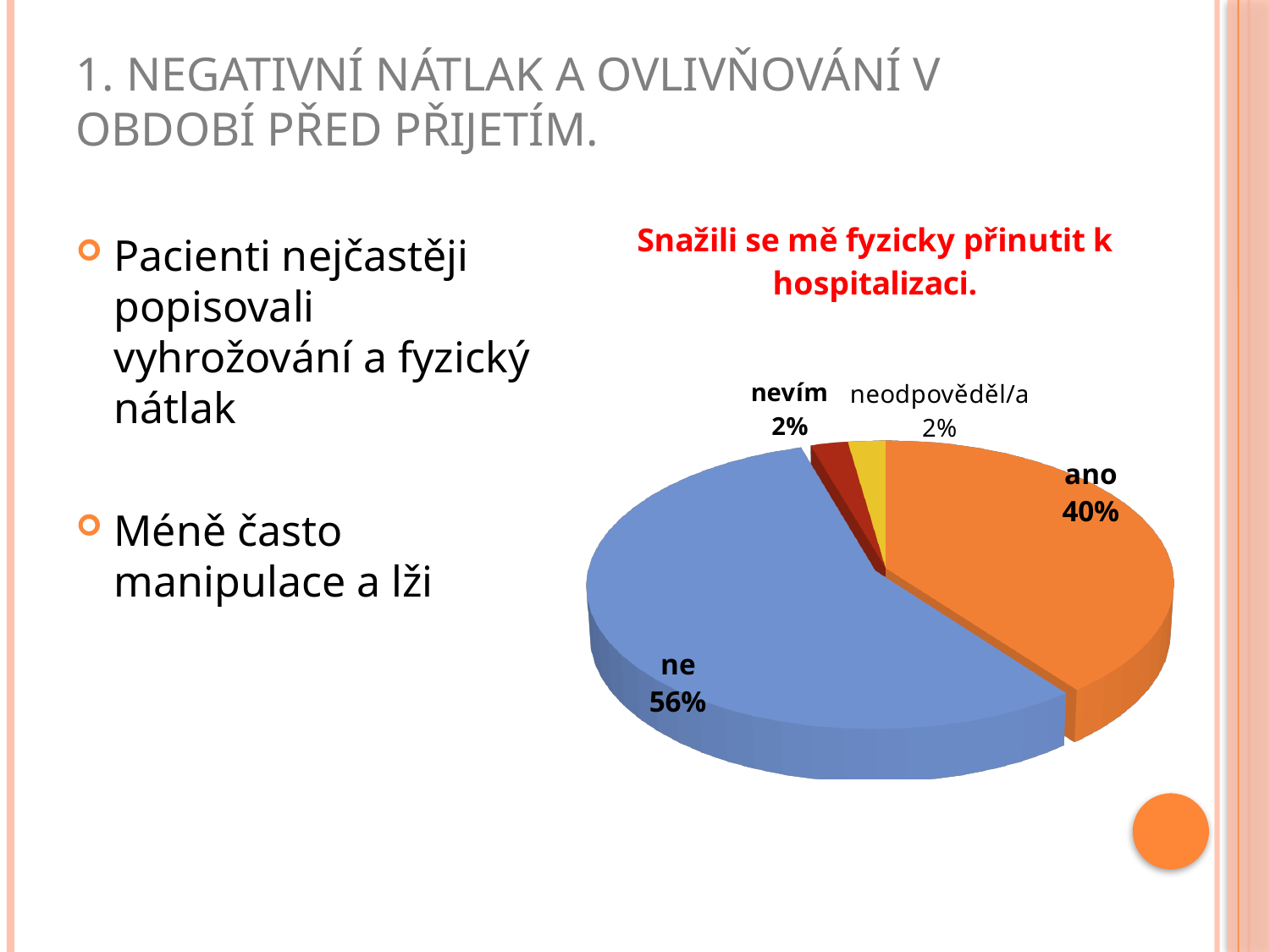
What is the combined share of the "nevím" and "neodpověděl/a" slices? 4% What is the difference in percentage points between the "ne" and "ano" slices? 16 What kind of chart is shown on the slide? pie chart What share of the pie is labelled "neodpověděl/a"? 2% What share of the pie is labelled "ano"? 40% What share of the pie is labelled "nevím"? 2% How many slices does the pie chart have? 4 Which is larger, the "ano" slice or the "ne" slice? ne What is the chart's title? Snažili se mě fyzicky přinutit k hospitalizaci. Which slice of the pie is the largest? ne What colour is the "ne" slice? blue